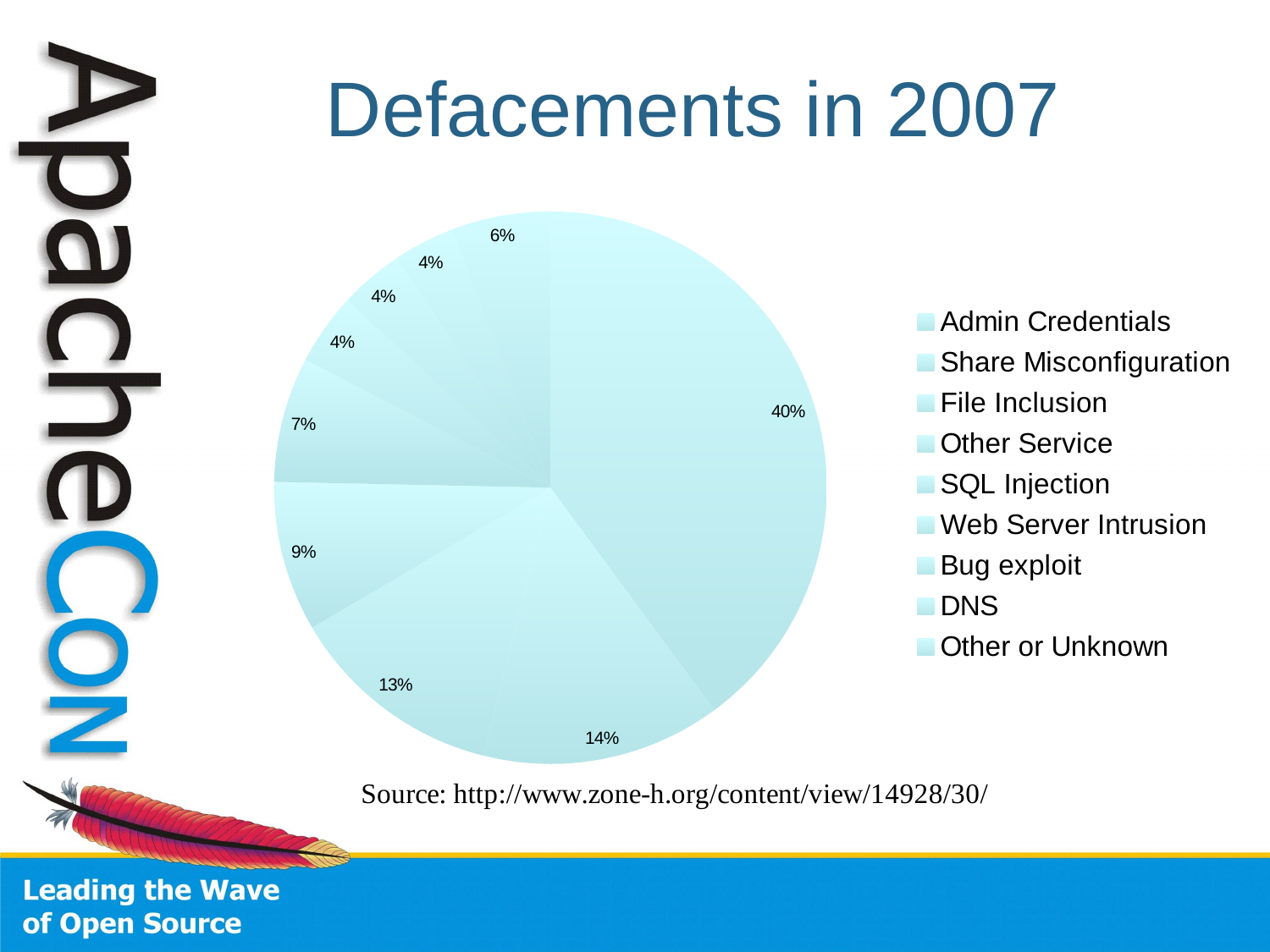
How many slices does the pie chart have? 9 What is the difference between the largest slice (40%) and the second-largest slice (14%)? 26% How many entries does the chart's legend list? 9 What is the combined share of the slices labelled 14% and 13%? 27% What is the percentage shown on the smallest slices of the pie? 4% What is the title of the chart? Defacements in 2007 What is the percentage shown on the largest slice of the pie? 40% What is the first entry listed in the chart's legend? Admin Credentials What kind of chart is shown on the slide? pie chart Which is larger, the slice labelled 13% or the slice labelled 9%? 13% How many slices of the pie are labelled 4%? 3 What is the difference between the slices labelled 7% and 6%? 1%